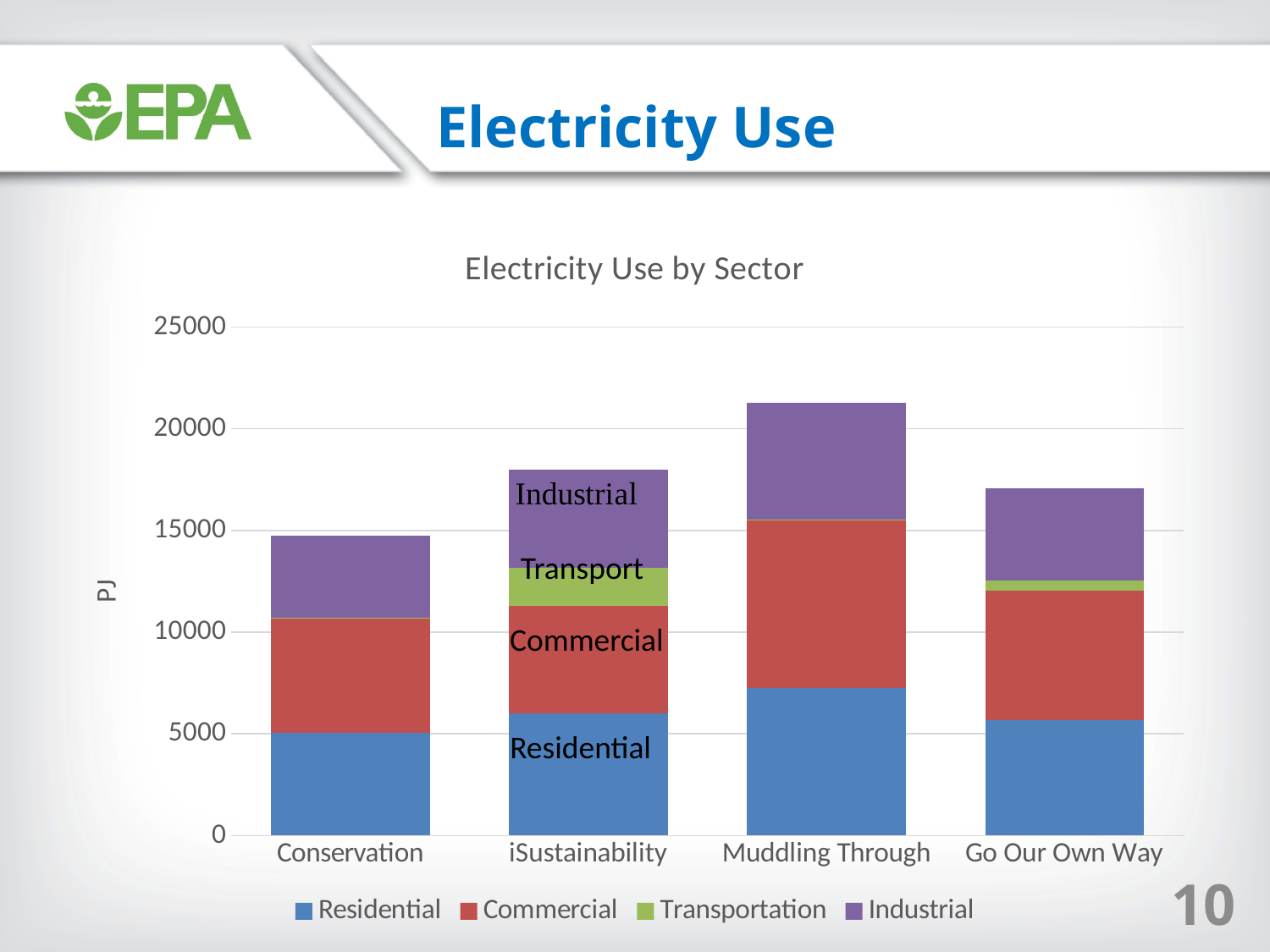
Which has the larger total electricity use, Muddling Through or Go Our Own Way? Muddling Through What kind of chart is shown on the slide? Stacked bar chart Is the Residential value for Muddling Through greater or less than 5000? greater Is the total electricity use for Muddling Through greater or less than 20000? greater How many scenario categories are shown on the x axis of the chart? 4 How many series does the chart legend list? 4 What unit is shown on the y axis of the chart? PJ Is the total electricity use for iSustainability greater or less than 15000? greater What is the title of the chart? Electricity Use by Sector Which scenario has the highest total electricity use? Muddling Through Which scenario has the lowest total electricity use? Conservation